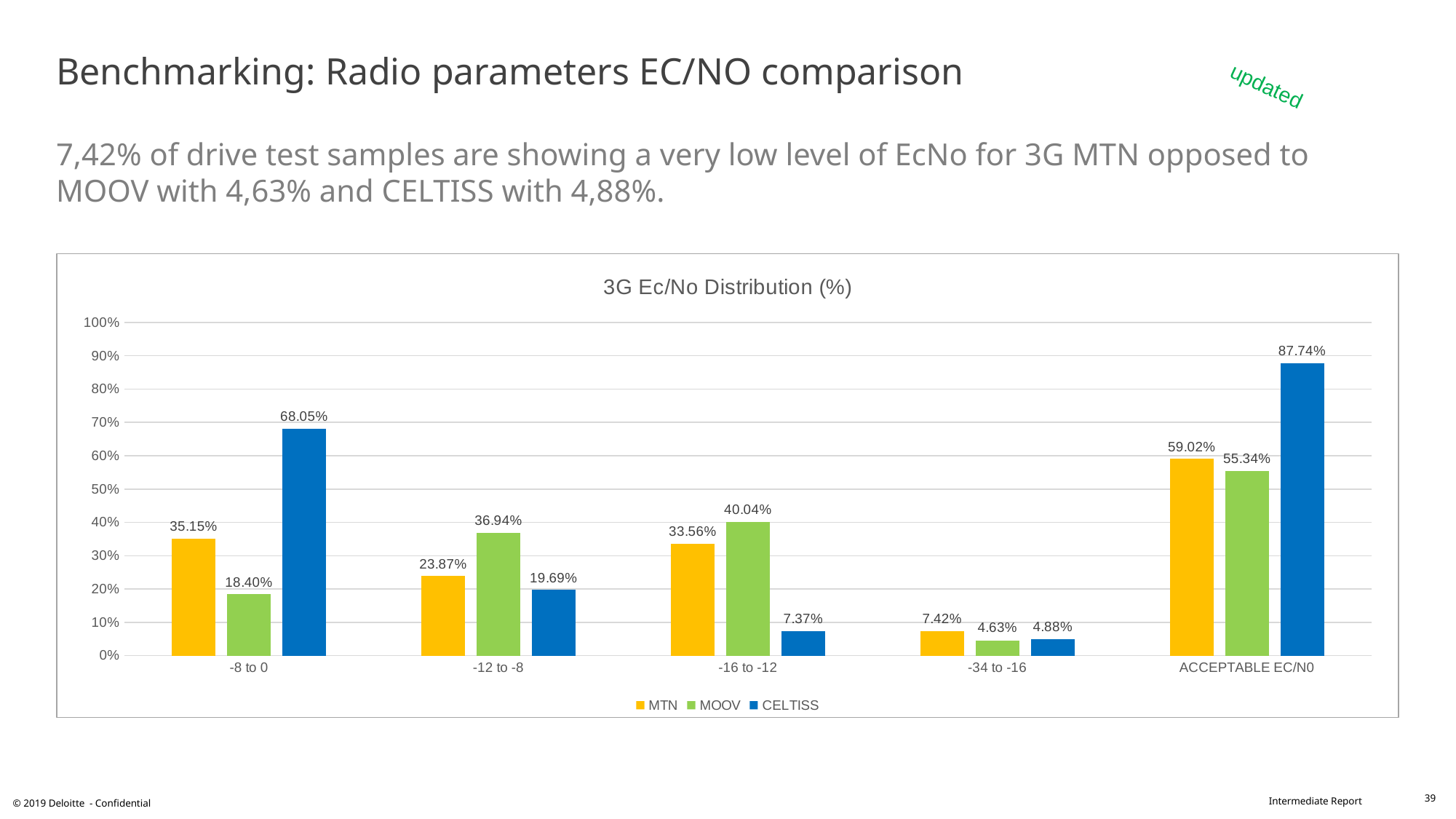
How many series does the legend list? 3 What is the difference between the MOOV and MTN values in the -12 to -8 category? 13.07% What is the value for MOOV in the -16 to -12 category? 40.04% Is the value for CELTISS in the -16 to -12 category greater or less than 10%? less What is the title of the chart? 3G Ec/No Distribution (%) Which series has the lowest value in the -34 to -16 category? MOOV Which series has the highest value in the ACCEPTABLE EC/N0 category? CELTISS Which is larger in the -8 to 0 category, MTN or MOOV? MTN What is the value for CELTISS in the -8 to 0 category? 68.05% How many categories are shown on the x axis? 5 What is the value for MTN in the ACCEPTABLE EC/N0 category? 59.02% What kind of chart is shown on the slide? bar chart